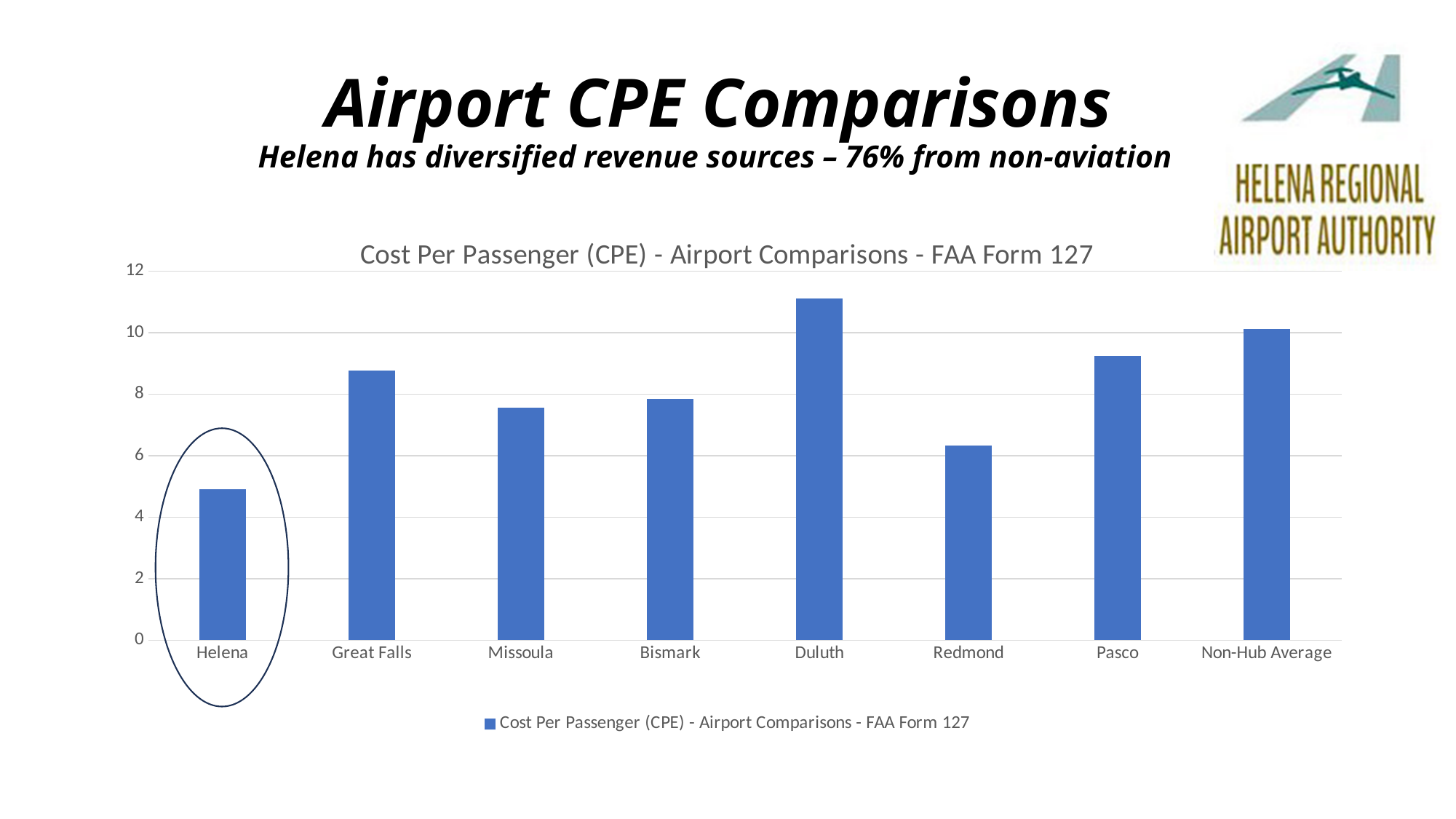
Which category has the lowest cost per passenger in the chart? Helena Is the value for Pasco greater or less than 8? greater Which has a higher cost per passenger, Great Falls or Missoula? Great Falls Which has a higher cost per passenger, Helena or Redmond? Redmond Is the value for Helena greater or less than 6? less Is the value for Duluth greater or less than 10? greater What kind of chart is shown on the slide? bar chart Which category has the highest cost per passenger in the chart? Duluth How many airports/categories are shown on the x axis of the chart? 8 Which has a higher cost per passenger, Duluth or Pasco? Duluth How many series does the chart legend list? 1 What is the title of the chart? Cost Per Passenger (CPE) - Airport Comparisons - FAA Form 127